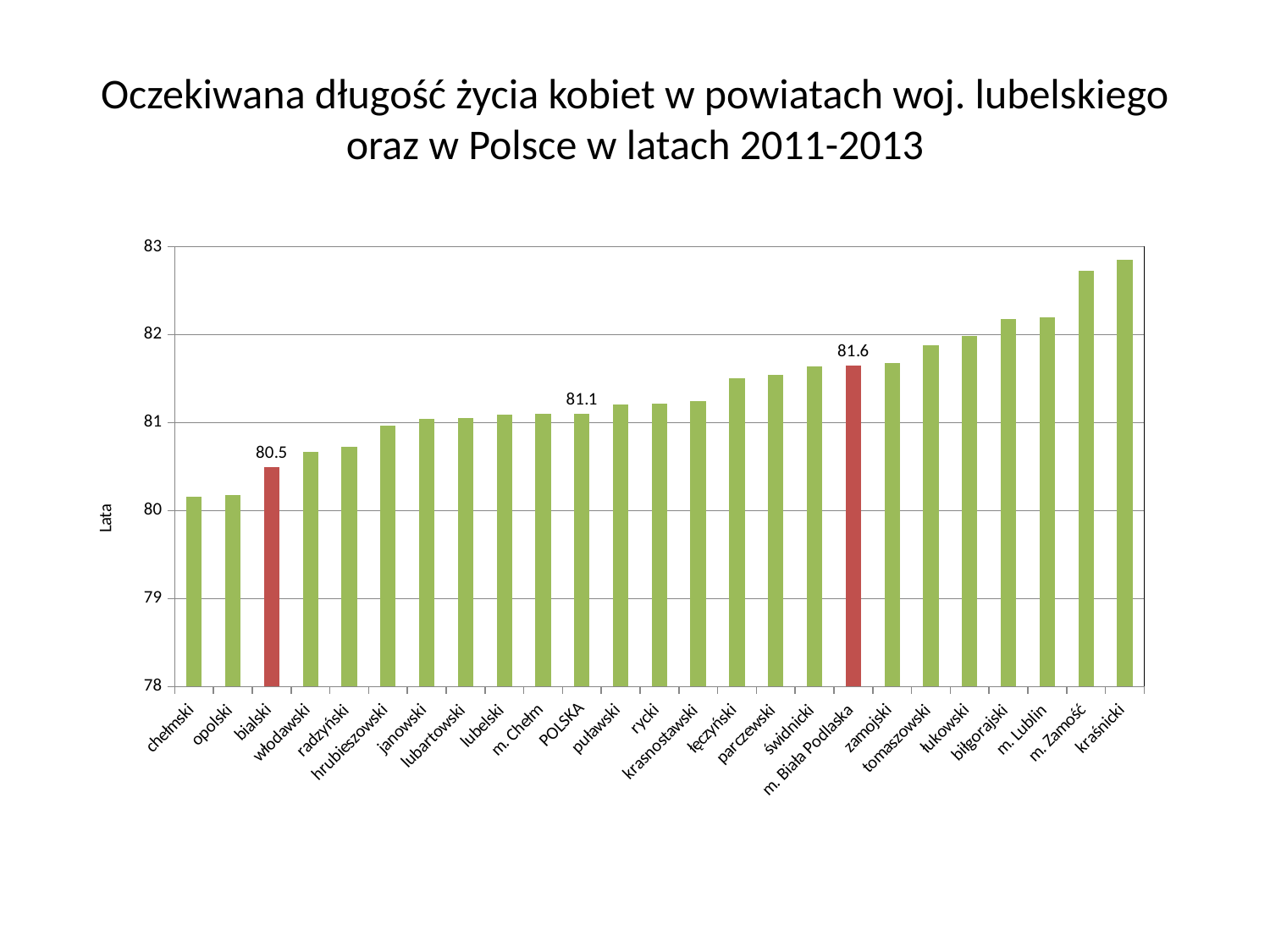
Which is larger, the value for POLSKA or the value for bialski? POLSKA What is the value for m. Biała Podlaska? 81.6 Which category has the highest value? kraśnicki What is the difference between the values for m. Biała Podlaska and POLSKA? 0.5 What kind of chart is this? bar chart Is the value for chełmski greater or less than 81? less Is the value for m. Lublin greater or less than 82? greater What is the value for bialski? 80.5 What is the difference between the values for m. Biała Podlaska and bialski? 1.1 What is the value for POLSKA? 81.1 How many categories are shown on the x axis? 25 Do the values rise or fall from left to right along the x axis? rise